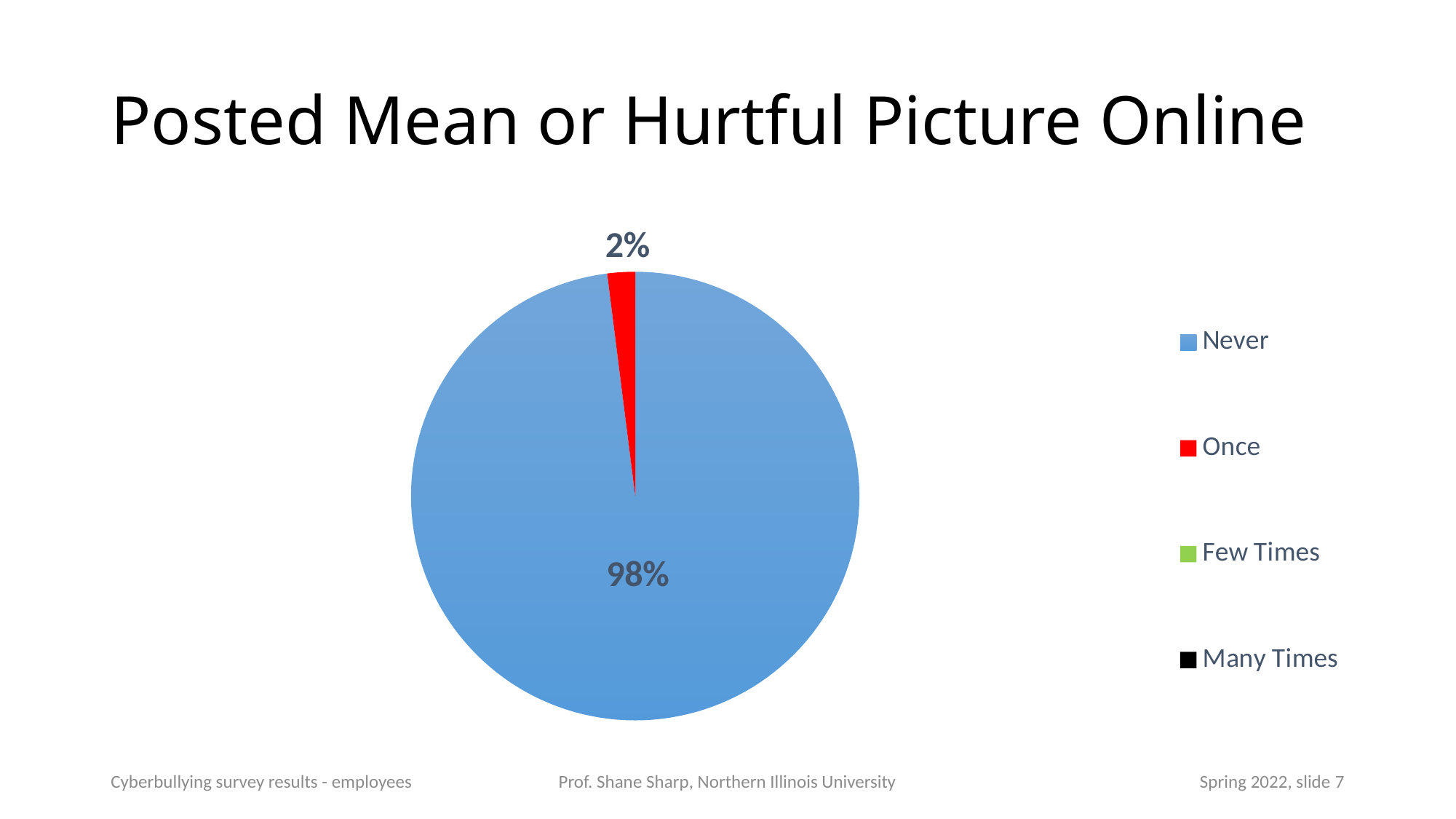
Which is larger, the Never slice or the Once slice? Never What is the difference between the Never share and the Once share? 96% What is the title of the chart? Posted Mean or Hurtful Picture Online How many slices are visibly labelled with a percentage on the pie? 2 What share of the pie does the Once slice represent? 2% How many entries does the legend list? 4 Which category has the largest slice of the pie? Never What kind of chart is shown on the slide? pie chart What share of the pie does the Never slice represent? 98% What colour is the Once slice in the pie chart? red